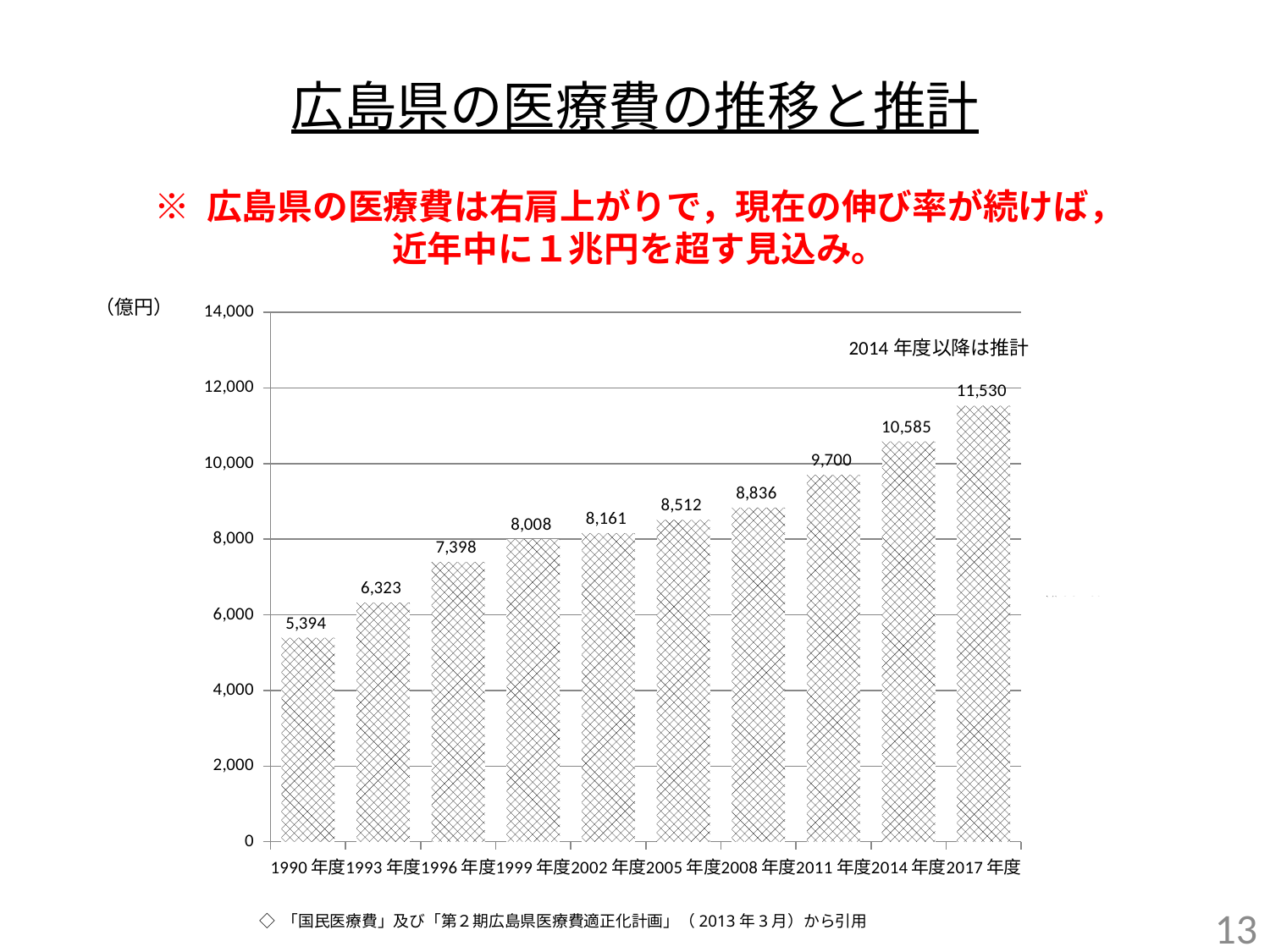
Which year has the highest value? 2017年度 What is the value for 1990年度? 5,394 How many years are shown on the x axis? 10 Do the values rise or fall from 1990年度 to 2017年度? rise Which is larger, the value for 2008年度 or the value for 2002年度? 2008年度 What is the difference between the values for 1993年度 and 1990年度? 929 What is the value for 2017年度? 11,530 What is the value for 2005年度? 8,512 What kind of chart is this? bar chart What is the difference between the values for 2017年度 and 2014年度? 945 Is the value for 2011年度 greater or less than 10,000? less Which year has the lowest value? 1990年度